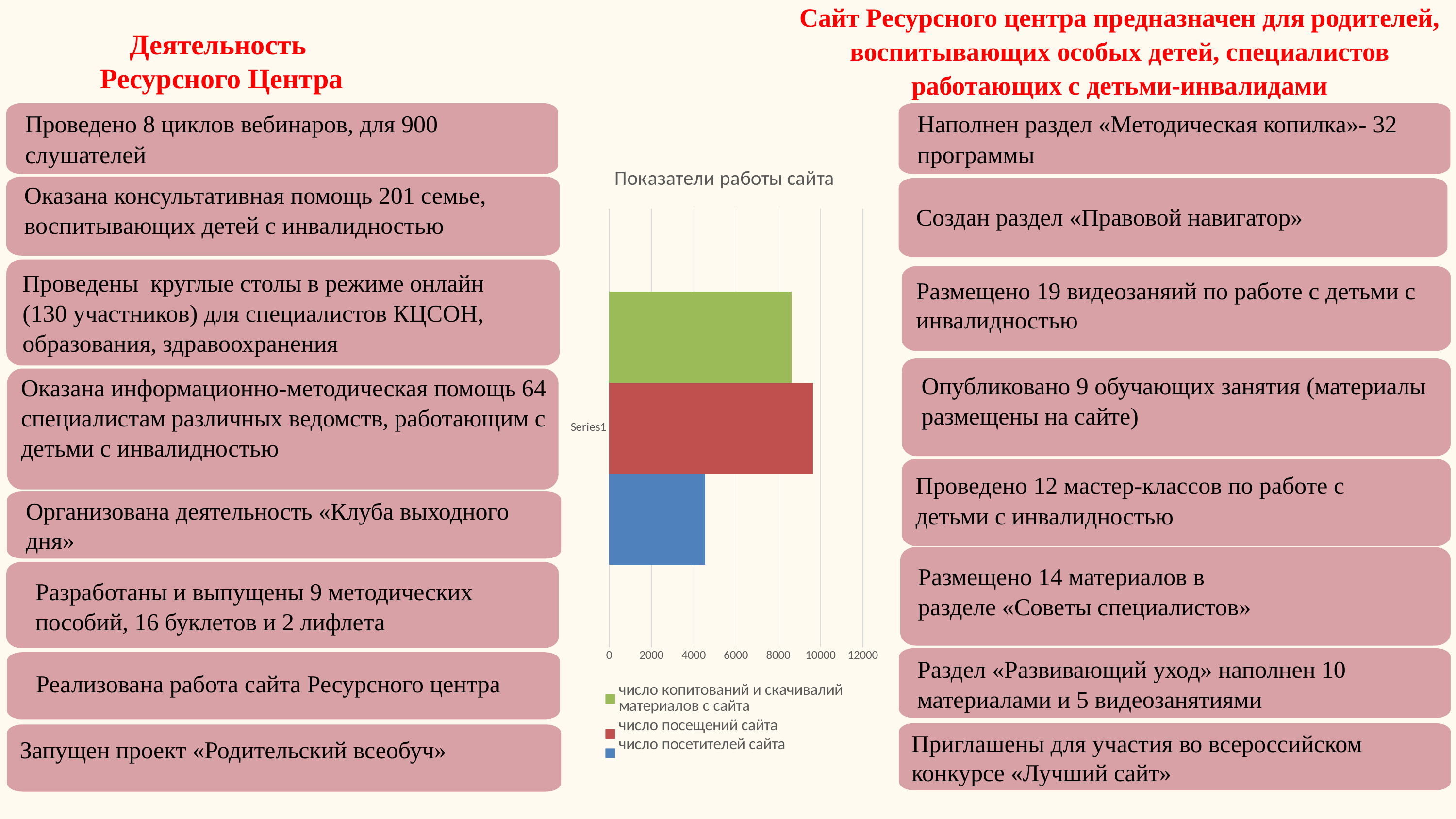
What kind of chart is shown under the title «Показатели работы сайта»? bar chart Is the value for число копитований и скачиваний материалов с сайта greater or less than 10000? less What is the title of the chart on the slide? Показатели работы сайта Which series has the longest bar in the chart? число посещений сайта Which is larger: число посещений сайта or число посетителей сайта? число посещений сайта What is the highest value shown on the chart's horizontal axis? 12000 Is the value for число посещений сайта greater or less than 8000? greater How many series does the chart legend list? 3 What colour is the bar for число посетителей сайта? blue Which series has the shortest bar in the chart? число посетителей сайта Which is larger: число копитований и скачиваний материалов с сайта or число посетителей сайта? число копитований и скачиваний материалов с сайта Is the value for число посетителей сайта greater or less than 6000? less